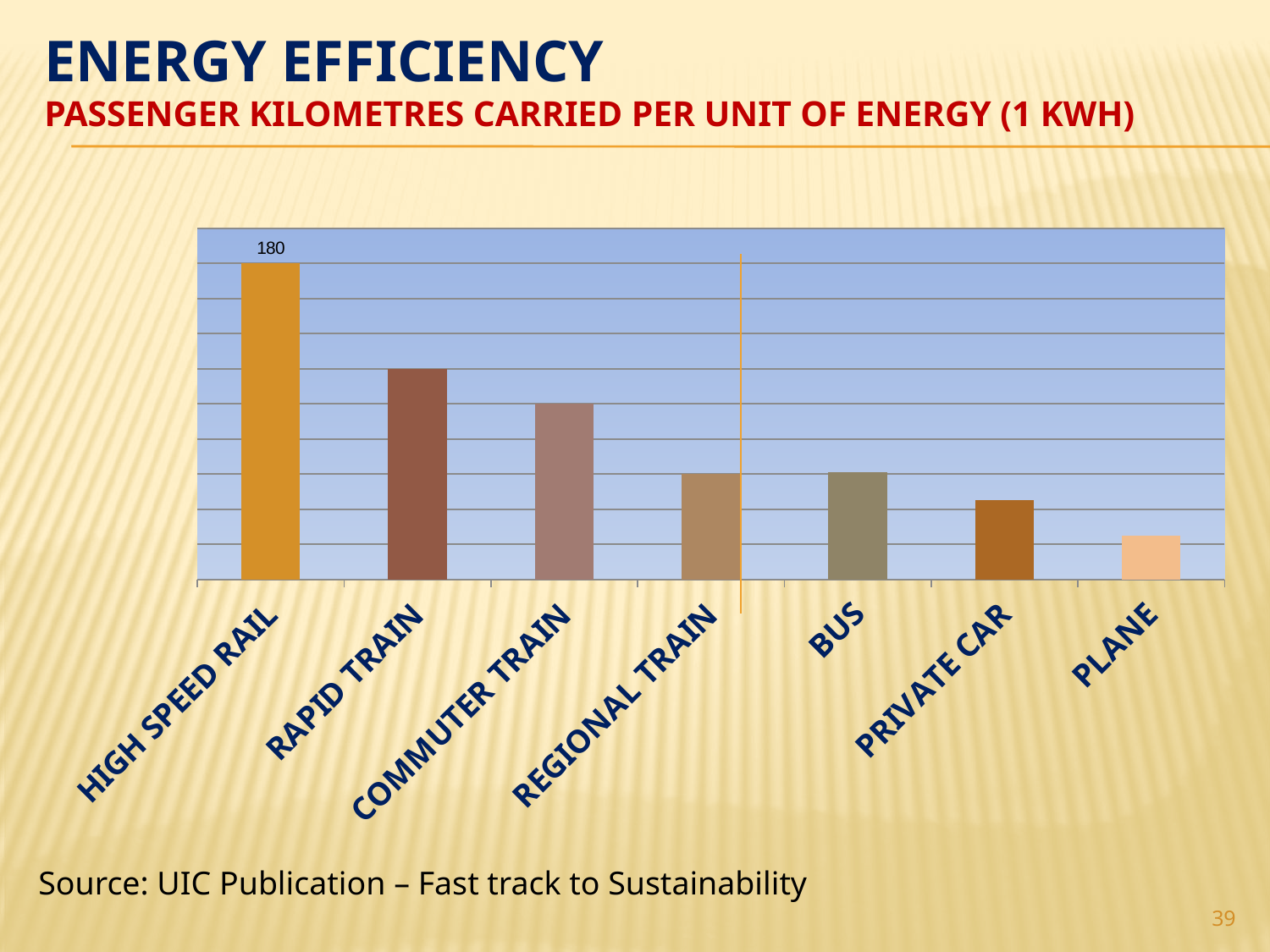
How many categories are shown on the x axis? 7 Which is larger, the value for Private Car or the value for Plane? Private Car Which category has the highest value? High Speed Rail What is the source cited for the chart? UIC Publication – Fast track to Sustainability What unit of energy is referred to in the slide subtitle? 1 kWh What is the value shown for High Speed Rail? 180 Which is larger, the value for Commuter Train or the value for Bus? Commuter Train What kind of chart is shown on the slide? Bar chart Which category has the lowest value? Plane Which is larger, the value for Bus or the value for Private Car? Bus Do the values generally rise or fall from left to right across the categories? Fall